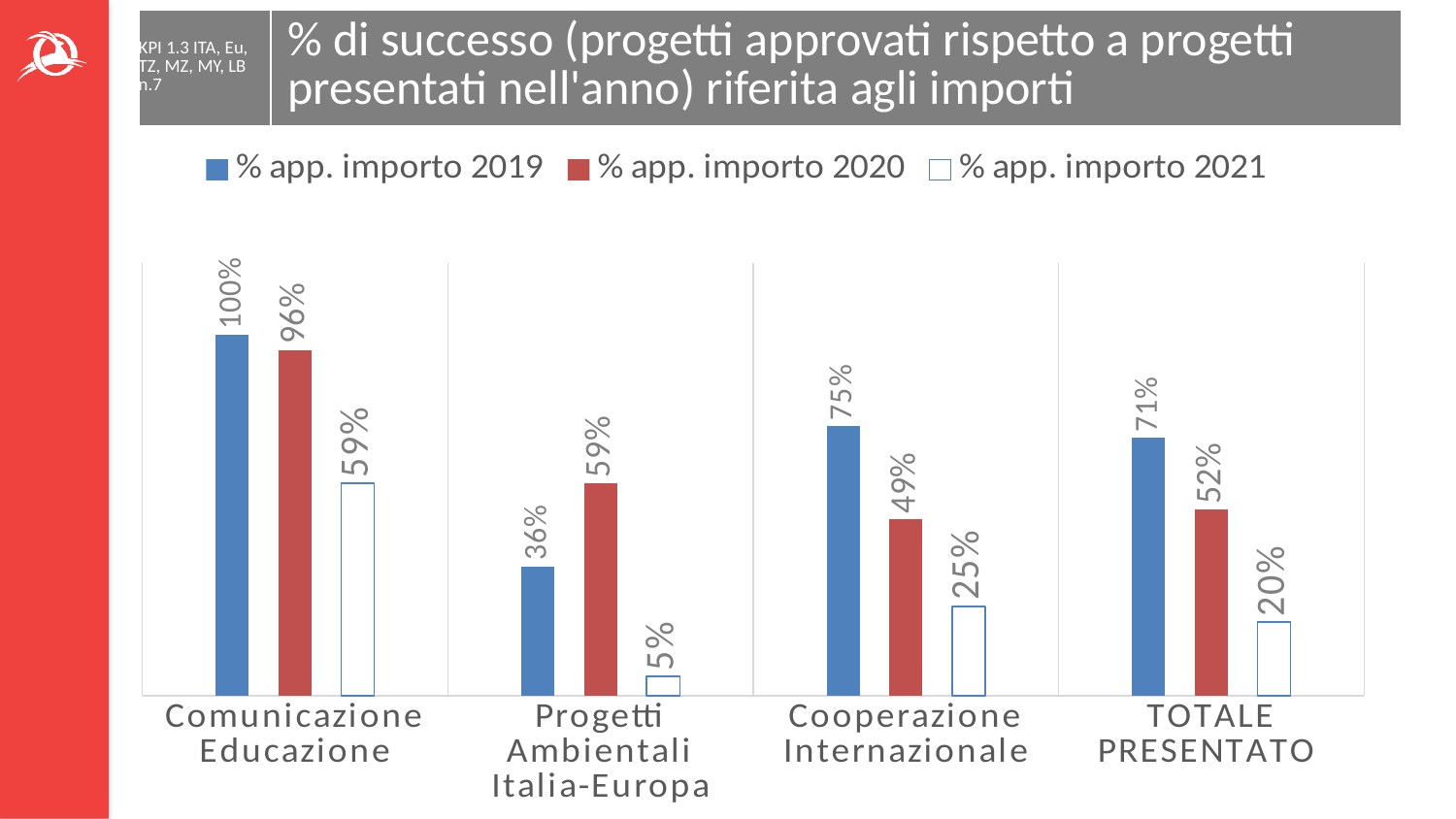
Which category has the lowest value for % app. importo 2019? Progetti Ambientali Italia-Europa What is the value of % app. importo 2021 for Progetti Ambientali Italia-Europa? 5% What is the value of % app. importo 2020 for Cooperazione Internazionale? 49% Which category has the highest value for % app. importo 2020? Comunicazione Educazione How many series does the legend list? 3 What is the value of % app. importo 2021 for TOTALE PRESENTATO? 20% Which series is shown with white (unfilled) bars? % app. importo 2021 What is the value of % app. importo 2019 for Comunicazione Educazione? 100% How many categories are shown on the x axis? 4 Which is larger for Progetti Ambientali Italia-Europa: % app. importo 2019 or % app. importo 2020? % app. importo 2020 What kind of chart is shown on the slide? Bar chart What is the difference between % app. importo 2019 and % app. importo 2021 for TOTALE PRESENTATO? 51%